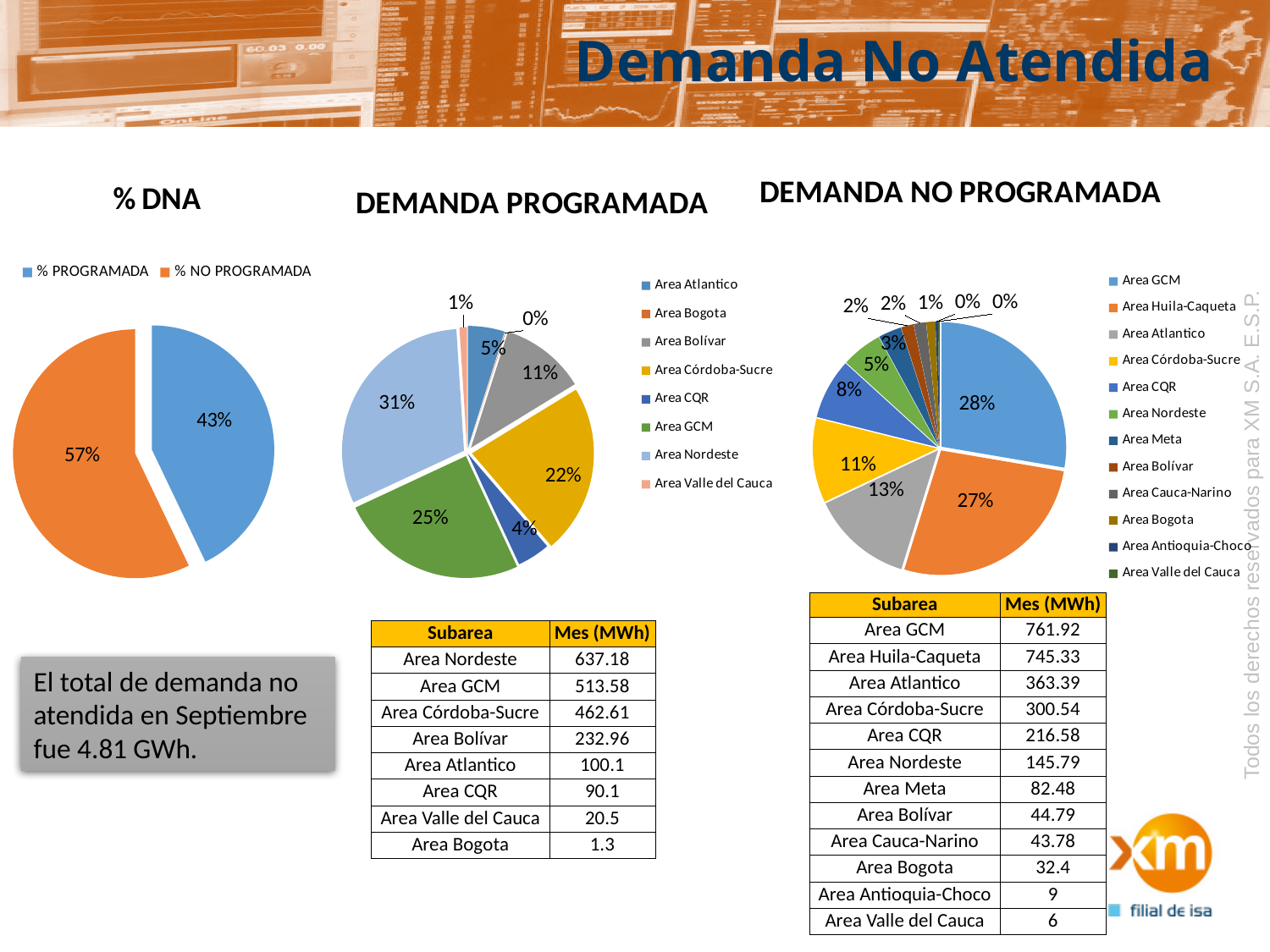
In the DEMANDA NO PROGRAMADA pie chart, what is the difference between the shares of Area GCM and Area Atlantico? 15% In the DEMANDA PROGRAMADA pie chart, what share does Area GCM have? 25% In the DEMANDA PROGRAMADA pie chart, which area has the largest share? Area Nordeste In the DEMANDA PROGRAMADA pie chart, what share does Area Nordeste have? 31% In the DEMANDA NO PROGRAMADA pie chart, which area has the largest share? Area GCM How many entries does the legend of the DEMANDA NO PROGRAMADA chart list? 12 What kind of chart is the DEMANDA PROGRAMADA chart? Pie chart In the % DNA pie chart, what share is % NO PROGRAMADA? 57% In the % DNA pie chart, what share is % PROGRAMADA? 43% How many entries does the legend of the DEMANDA PROGRAMADA chart list? 8 In the DEMANDA NO PROGRAMADA pie chart, what share does Area Huila-Caqueta have? 27% In the % DNA chart, which is larger, % PROGRAMADA or % NO PROGRAMADA? % NO PROGRAMADA